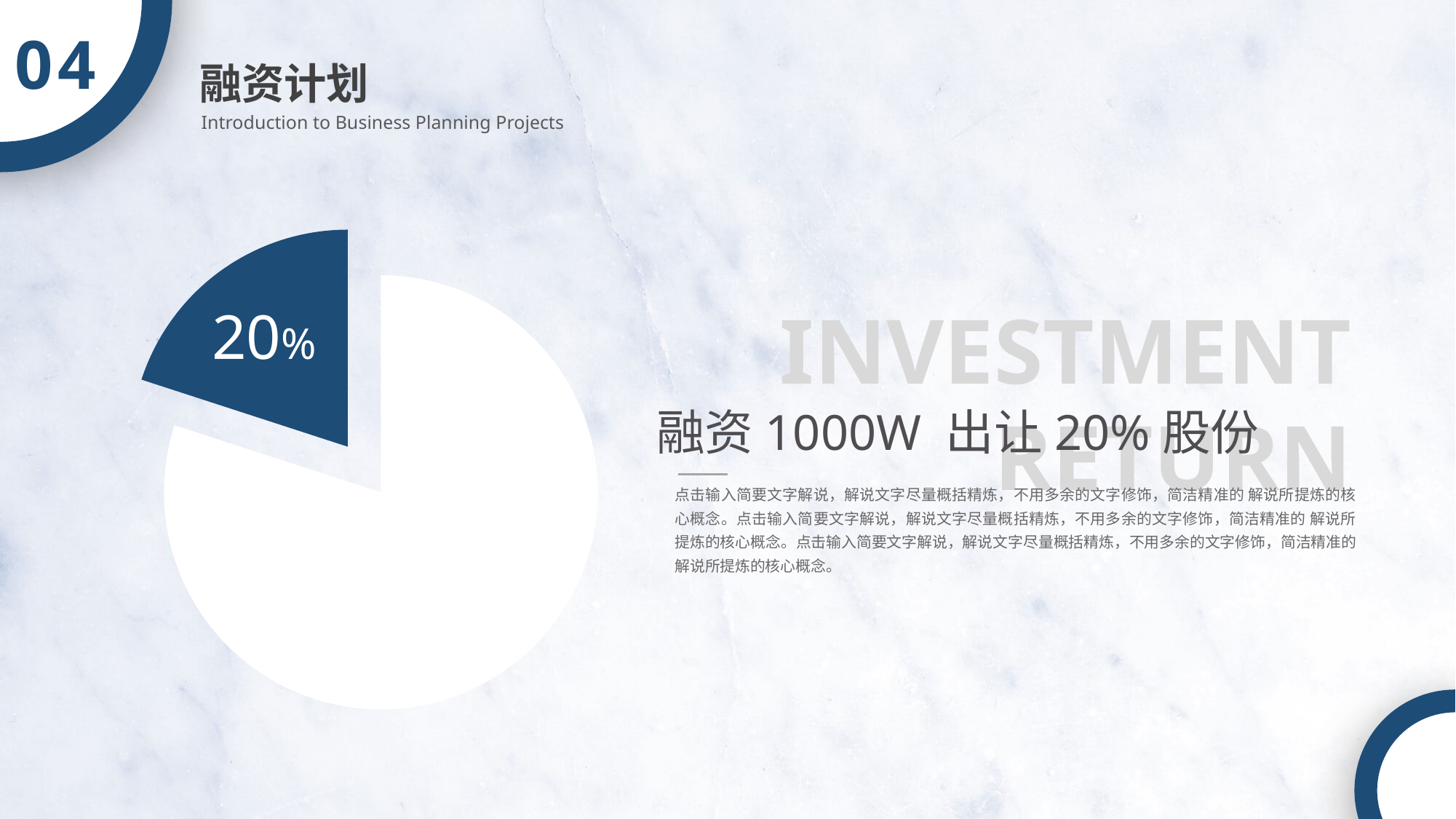
How many slices does the pie chart have? 2 Which slice of the pie chart is the smallest? the blue slice What colour is the slice of the pie chart that carries the 20% label? blue What percentage is printed on the blue slice of the pie chart? 20% What kind of chart is shown on the left of the slide? pie chart Which slice of the pie chart is larger, the blue slice or the white slice? the white slice What share of the pie does the blue slice represent? 20% What share of the pie does the white slice represent? 80% According to the text beside the pie chart, what share of equity is offered for the 1000W financing? 20%